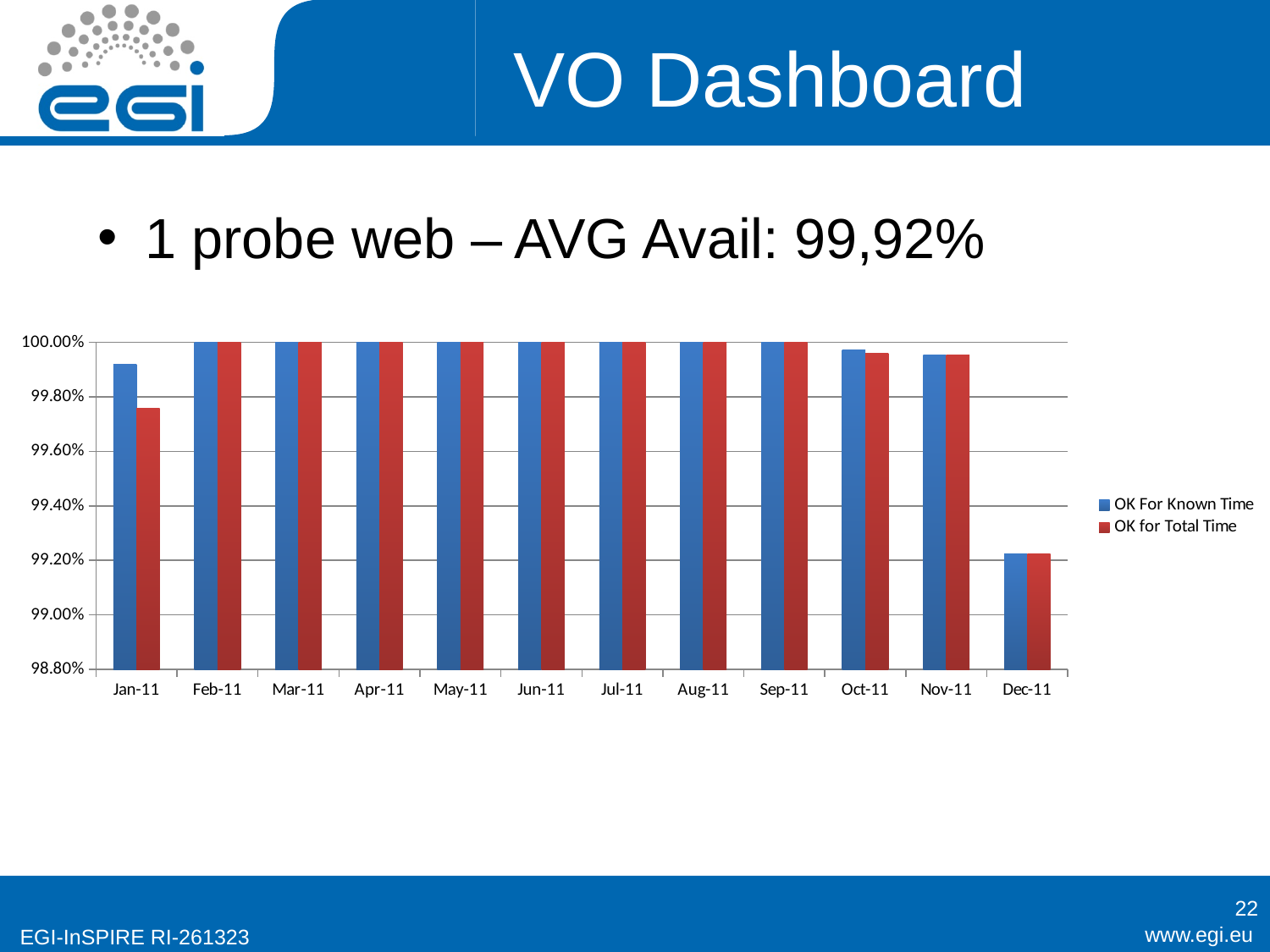
How many months are shown on the x axis of the chart? 12 Is the value for OK For Known Time in Oct-11 greater or less than 99.80%? greater What kind of chart is shown on the slide? bar chart Which month has the lowest value for OK for Total Time? Dec-11 Is the value for OK for Total Time in Dec-11 greater or less than 99.40%? less What is the value for OK For Known Time in Feb-11? 100.00% Is the value for OK for Total Time in Jan-11 greater or less than 99.80%? less In Jan-11, which series has the larger value, OK For Known Time or OK for Total Time? OK For Known Time Which month has the lowest value for OK For Known Time? Dec-11 Which colour represents the OK for Total Time series in the chart? red What is the value for OK for Total Time in Jul-11? 100.00% How many series does the legend list? 2